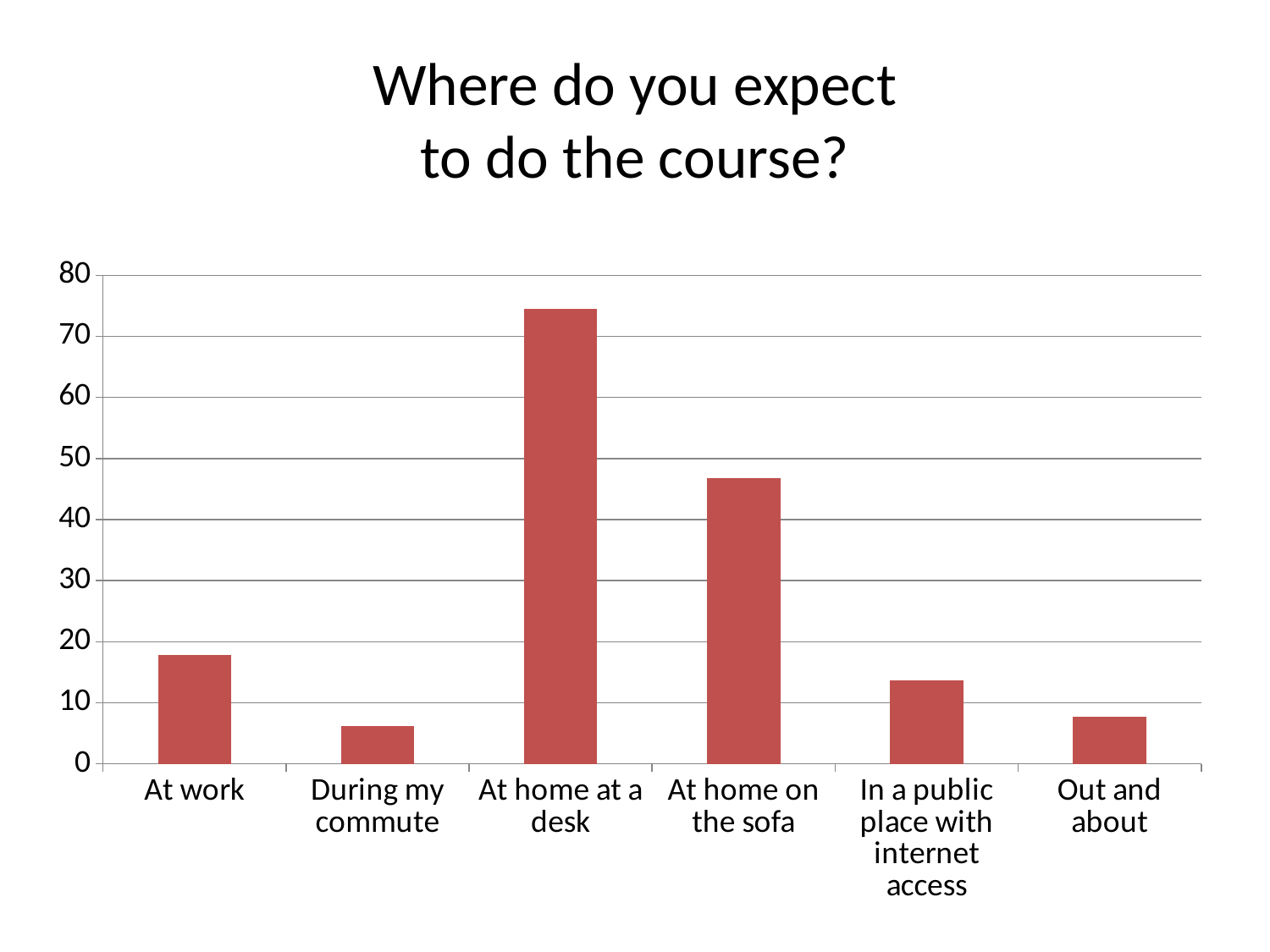
What is the title of the chart? Where do you expect to do the course? Is the value for At home on the sofa greater or less than 50? less Which category has the highest value? At home at a desk Which is larger, the value for At work or the value for In a public place with internet access? At work Is the value for At home at a desk greater or less than 70? greater Is the value for At work greater or less than 20? less How many categories are shown on the x axis? 6 Which is larger, the value for At home on the sofa or the value for At work? At home on the sofa What kind of chart is shown on the slide? bar chart